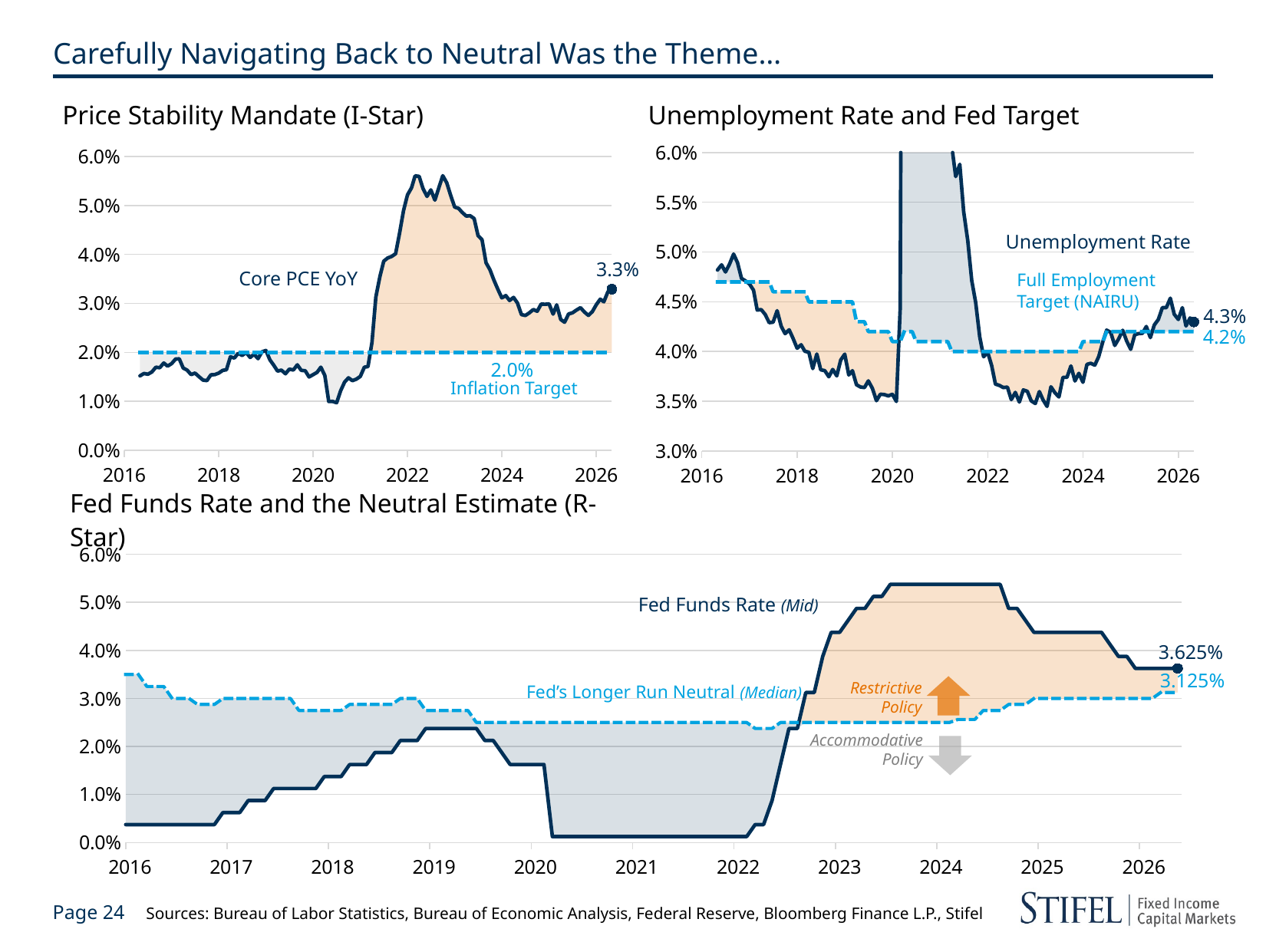
In the Price Stability Mandate (I-Star) chart, what is the Inflation Target level shown by the dashed line? 2.0% In the Price Stability Mandate (I-Star) chart, what is the latest labeled value of Core PCE YoY? 3.3% In the Unemployment Rate and Fed Target chart, what is the latest labeled Full Employment Target (NAIRU)? 4.2% In the Unemployment Rate and Fed Target chart, which is larger at the end of the series: the Unemployment Rate or the Full Employment Target (NAIRU)? Unemployment Rate In the Unemployment Rate and Fed Target chart, what is the latest labeled Unemployment Rate? 4.3% In the Fed Funds Rate and the Neutral Estimate (R-Star) chart, what is the latest labeled value of the Fed's Longer Run Neutral (Median)? 3.125% What kind of chart is the Fed Funds Rate and the Neutral Estimate (R-Star) chart? Combination area and line chart (lines with shaded areas between them) In the Price Stability Mandate (I-Star) chart, is the peak of Core PCE YoY around 2022 greater or less than 5.0%? greater In the Price Stability Mandate (I-Star) chart, by how many percentage points does the latest Core PCE YoY value (3.3%) exceed the 2.0% Inflation Target? 1.3 percentage points In the Fed Funds Rate and the Neutral Estimate (R-Star) chart, what is the latest labeled Fed Funds Rate (Mid)? 3.625% In the Fed Funds Rate and the Neutral Estimate (R-Star) chart, what is the difference between the latest Fed Funds Rate (3.625%) and the Fed's Longer Run Neutral (3.125%)? 0.5 percentage points